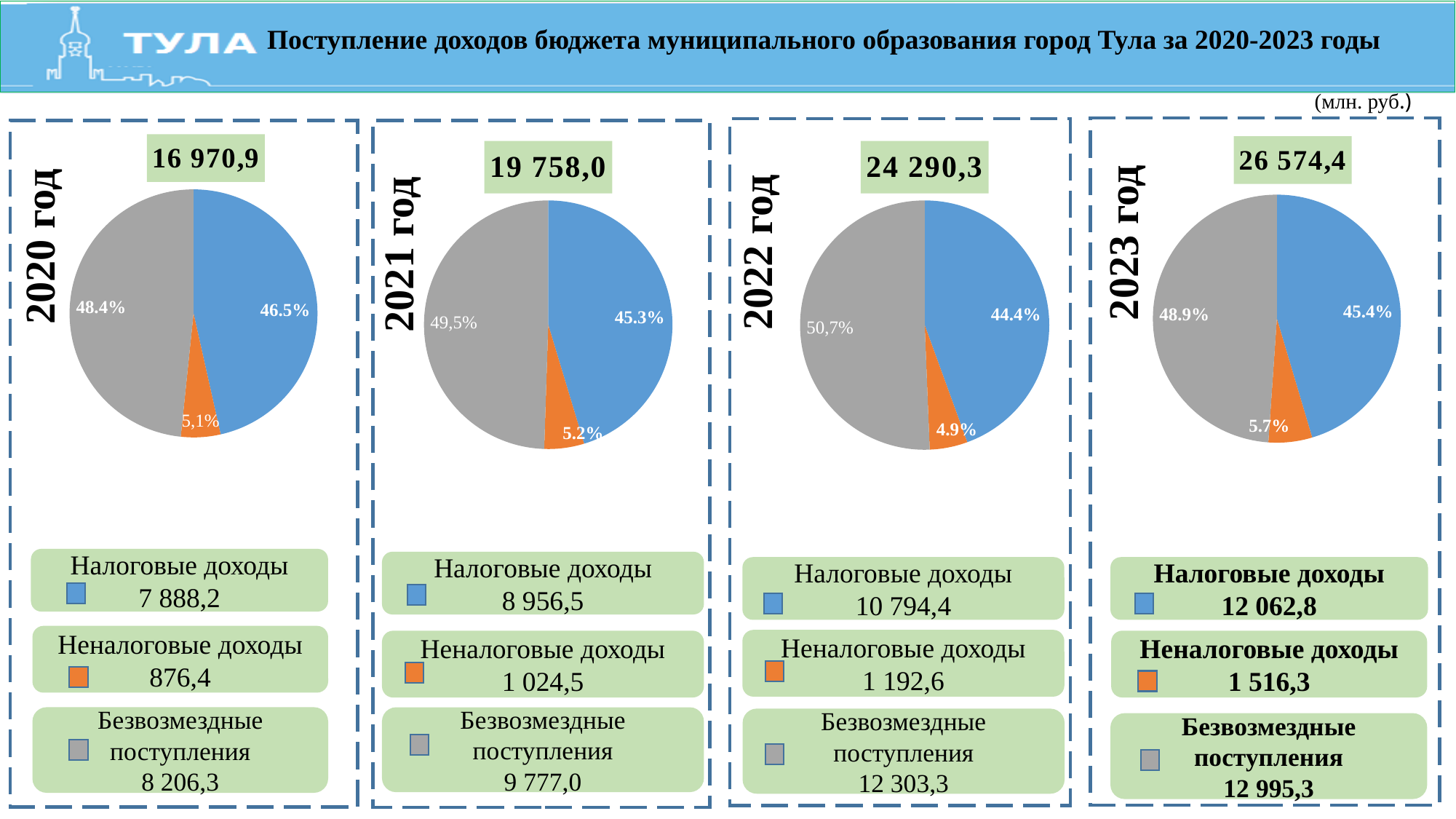
What is the value of Налоговые доходы in the 2023 год panel? 12 062,8 What is the value of Неналоговые доходы in the 2020 год panel? 876,4 In the 2021 год pie chart, what share does Налоговые доходы have? 45.3% In the 2022 год pie chart, what share does Неналоговые доходы have? 4.9% Which is larger in the 2021 год panel: Налоговые доходы or Безвозмездные поступления? Безвозмездные поступления What kind of chart is used for the 2020 год panel? pie chart What colour represents Неналоговые доходы in the pie charts? orange In the 2023 год pie chart, which category has the largest slice? Безвозмездные поступления How many slices does each pie chart on the slide have? 3 In the 2020 год pie chart, what share does Безвозмездные поступления have? 48.4% What total is shown above the 2022 год pie chart? 24 290,3 In the 2022 год pie chart, which category has the smallest slice? Неналоговые доходы